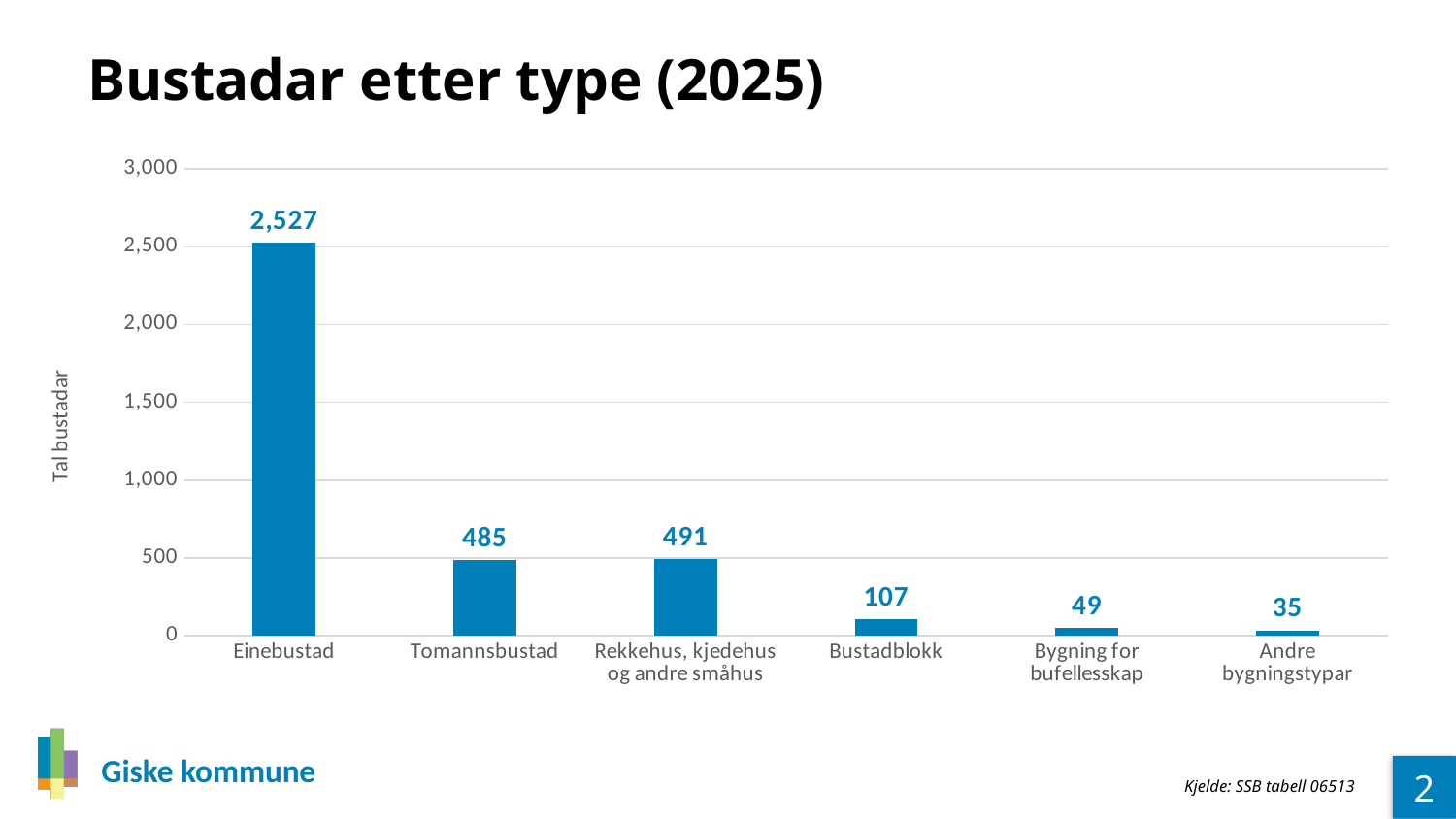
What is the value for Einebustad? 2,527 Which category has the lowest value? Andre bygningstypar What is the difference between the values for Einebustad and Tomannsbustad? 2,042 Which category has the highest value? Einebustad What is the value for Bygning for bufellesskap? 49 Is the value for Tomannsbustad greater or less than 500? less What is the difference between the values for Bustadblokk and Andre bygningstypar? 72 Which is larger, the value for Tomannsbustad or the value for Rekkehus, kjedehus og andre småhus? Rekkehus, kjedehus og andre småhus What kind of chart is shown on the slide? bar chart How many categories are shown on the x axis? 6 What is the value for Bustadblokk? 107 What is the title of the chart? Bustadar etter type (2025)